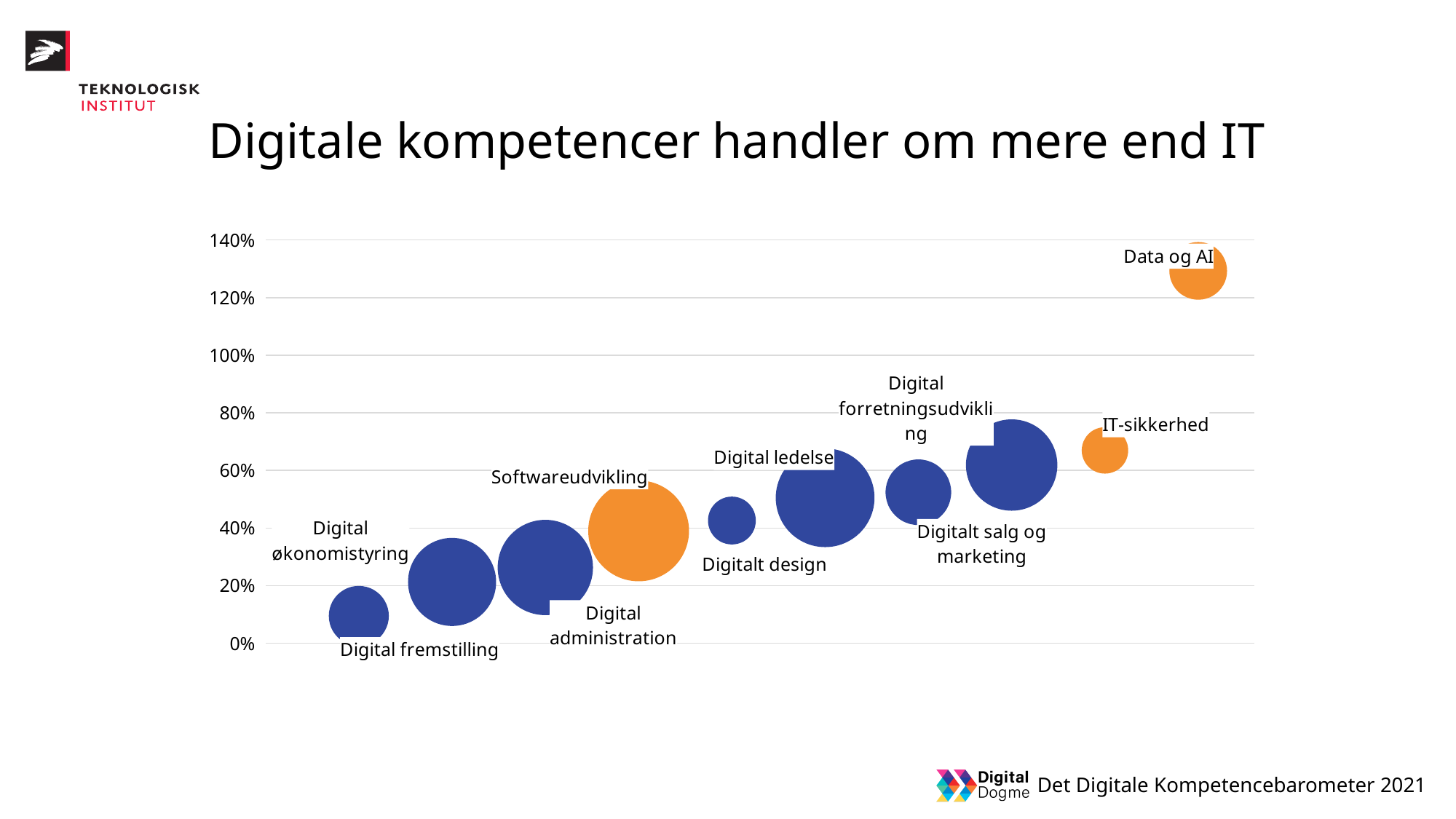
Is the value for Digital fremstilling greater or less than 20%? less Is the value for Data og AI greater or less than 120%? greater Which category has the lowest value on the chart? Digital fremstilling Is the value for Softwareudvikling greater or less than 60%? less What is the title of the slide? Digitale kompetencer handler om mere end IT What kind of chart is shown on the slide? bubble chart Which has the larger value, Digital fremstilling or Digitalt design? Digitalt design Which has the larger value, Data og AI or IT-sikkerhed? Data og AI Which category has the highest value on the chart? Data og AI Do the bubble values generally rise or fall from left to right across the chart? rise How many bubbles (categories) are plotted on the chart? 10